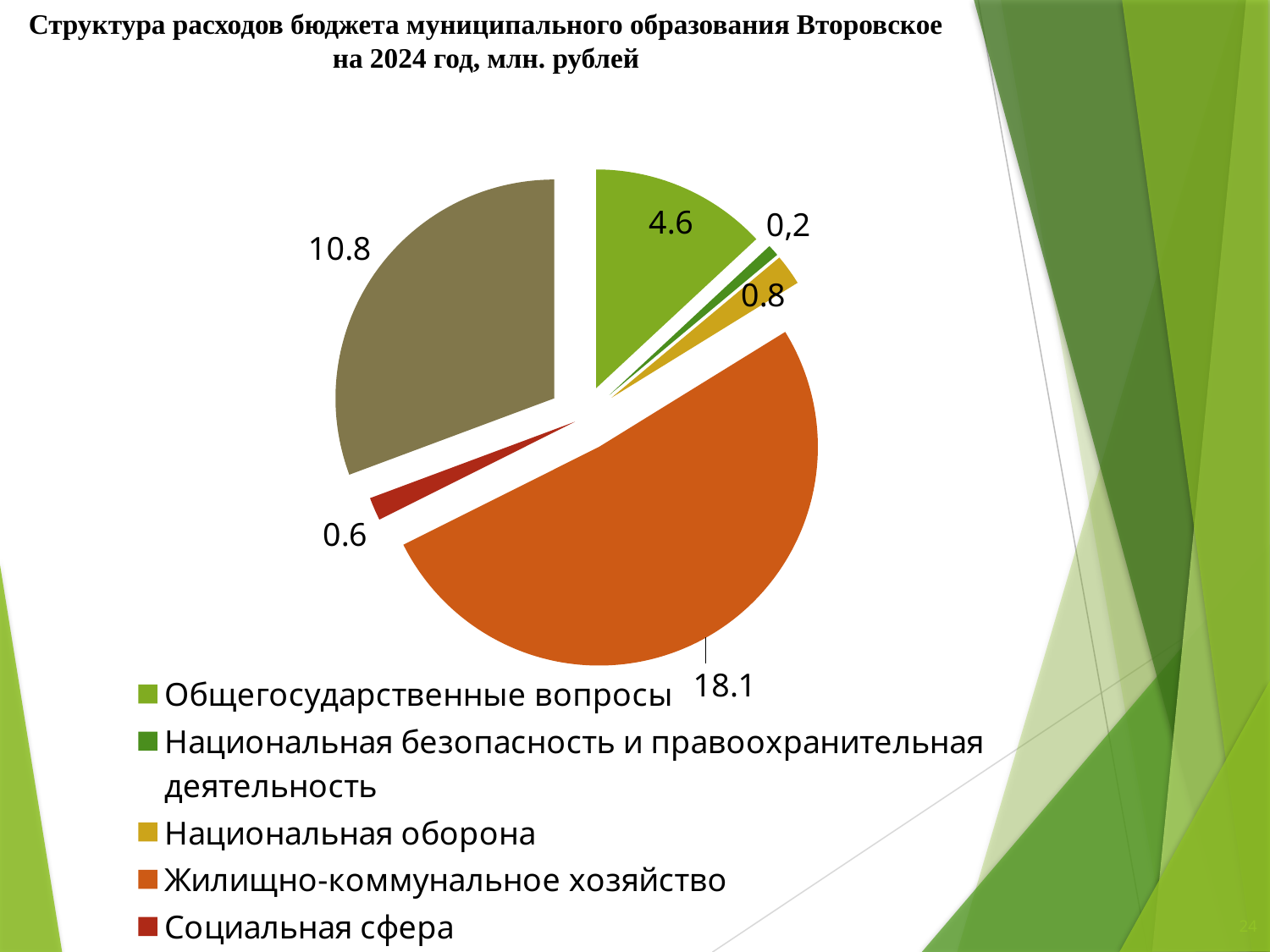
What is the difference between the values for Жилищно-коммунальное хозяйство and Общегосударственные вопросы? 13.5 Which category has the smallest slice of the pie? Национальная безопасность и правоохранительная деятельность How many slices does the pie chart have? 6 How many entries does the legend list? 5 Which category has the largest slice of the pie? Жилищно-коммунальное хозяйство What kind of chart is shown on the slide? pie chart What is the value for Национальная оборона? 0.8 What is the value for Жилищно-коммунальное хозяйство? 18.1 Which is larger, the value for Национальная оборона or the value for Социальная сфера? Национальная оборона What is the value for Национальная безопасность и правоохранительная деятельность? 0,2 What is the value for Общегосударственные вопросы? 4.6 What is the value for Социальная сфера? 0.6